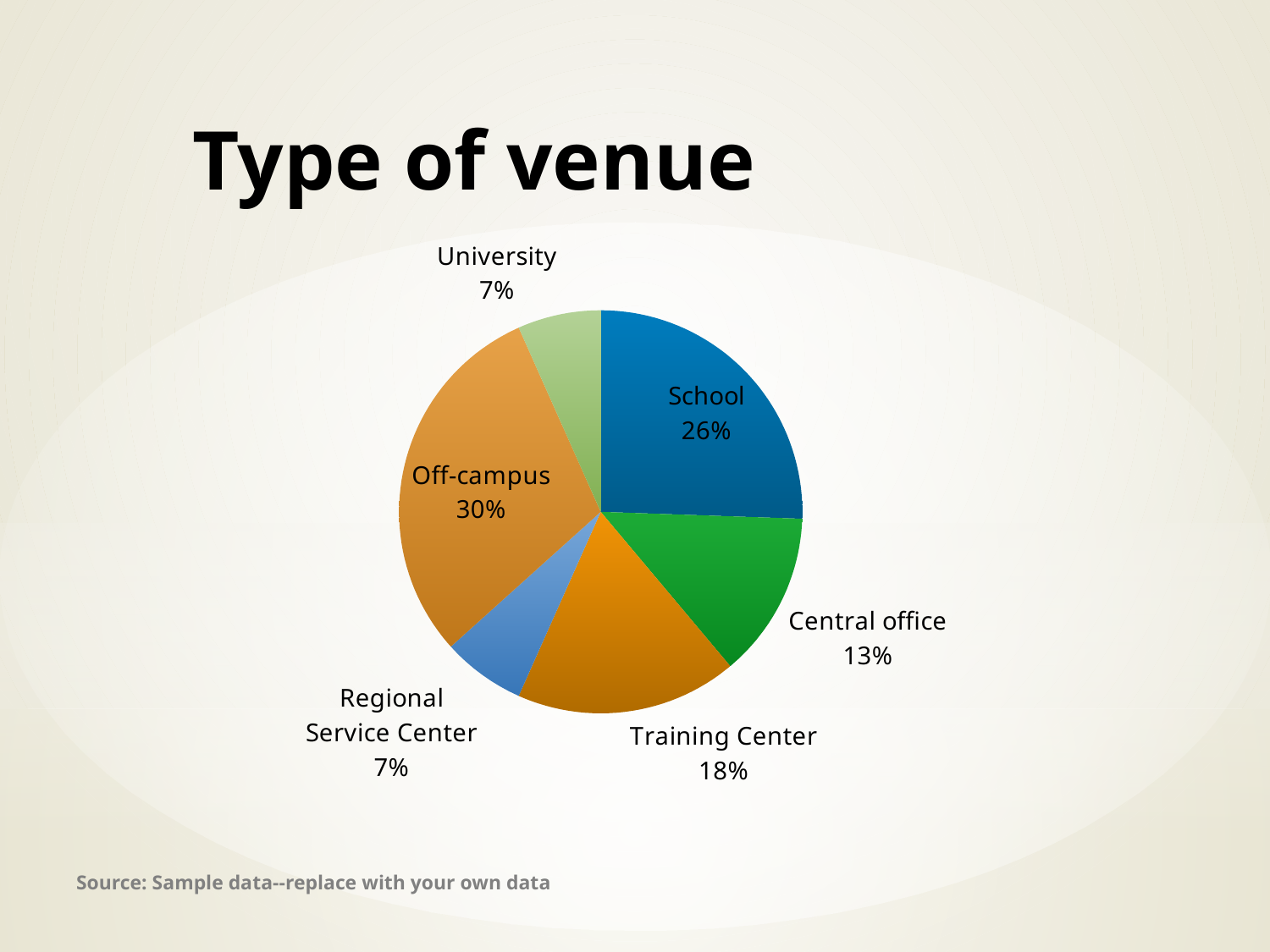
What share of the pie does Off-campus represent? 30% Which two categories share the same value of 7%? University and Regional Service Center How many categories are shown in the pie chart? 6 What is the value shown for School? 26% What kind of chart is shown on the slide? Pie chart What is the value for Central office? 13% Which type of venue has the largest share? Off-campus What is the difference between the Off-campus and School shares? 4% What percentage is shown for Training Center? 18% What is the difference between the Training Center and Central office shares? 5% Which is larger, School or Training Center? School What is the title of the chart? Type of venue